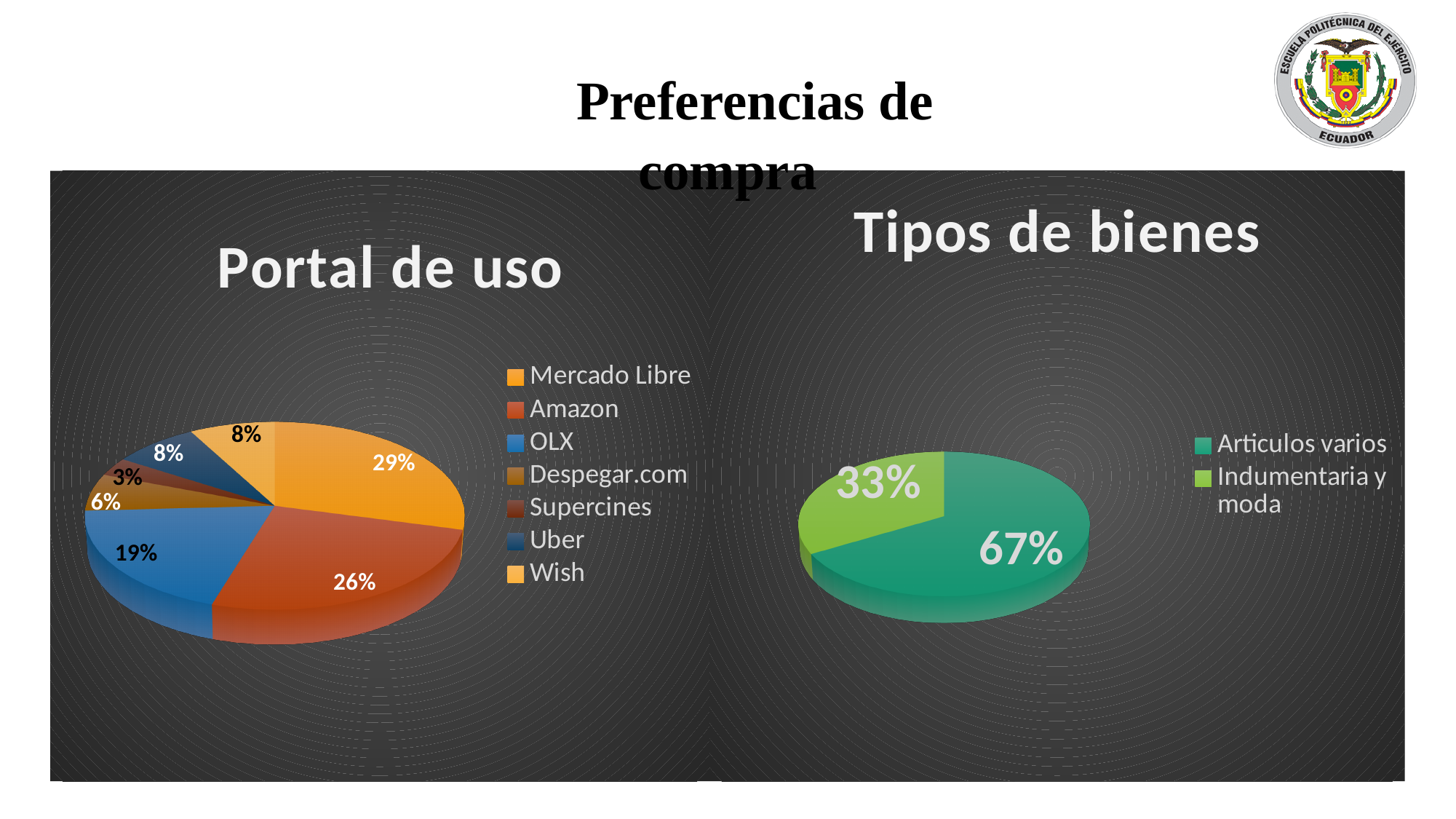
In the 'Portal de uso' chart, which portal has the largest share? Mercado Libre How many portals are listed in the legend of the 'Portal de uso' chart? 7 In the 'Portal de uso' chart, what share does Mercado Libre have? 29% What kind of chart is 'Tipos de bienes'? Pie chart In the 'Portal de uso' chart, which portal has the smallest share? Supercines How many categories does the legend of the 'Tipos de bienes' chart list? 2 In the 'Portal de uso' chart, what share does Amazon have? 26% In the 'Tipos de bienes' chart, what share does 'Articulos varios' have? 67% In the 'Tipos de bienes' chart, what share does 'Indumentaria y moda' have? 33% In the 'Portal de uso' chart, which has a larger share, OLX or Uber? OLX In the 'Portal de uso' chart, what share does OLX have? 19% In the 'Portal de uso' chart, what is the difference between the shares of Mercado Libre and Amazon? 3%